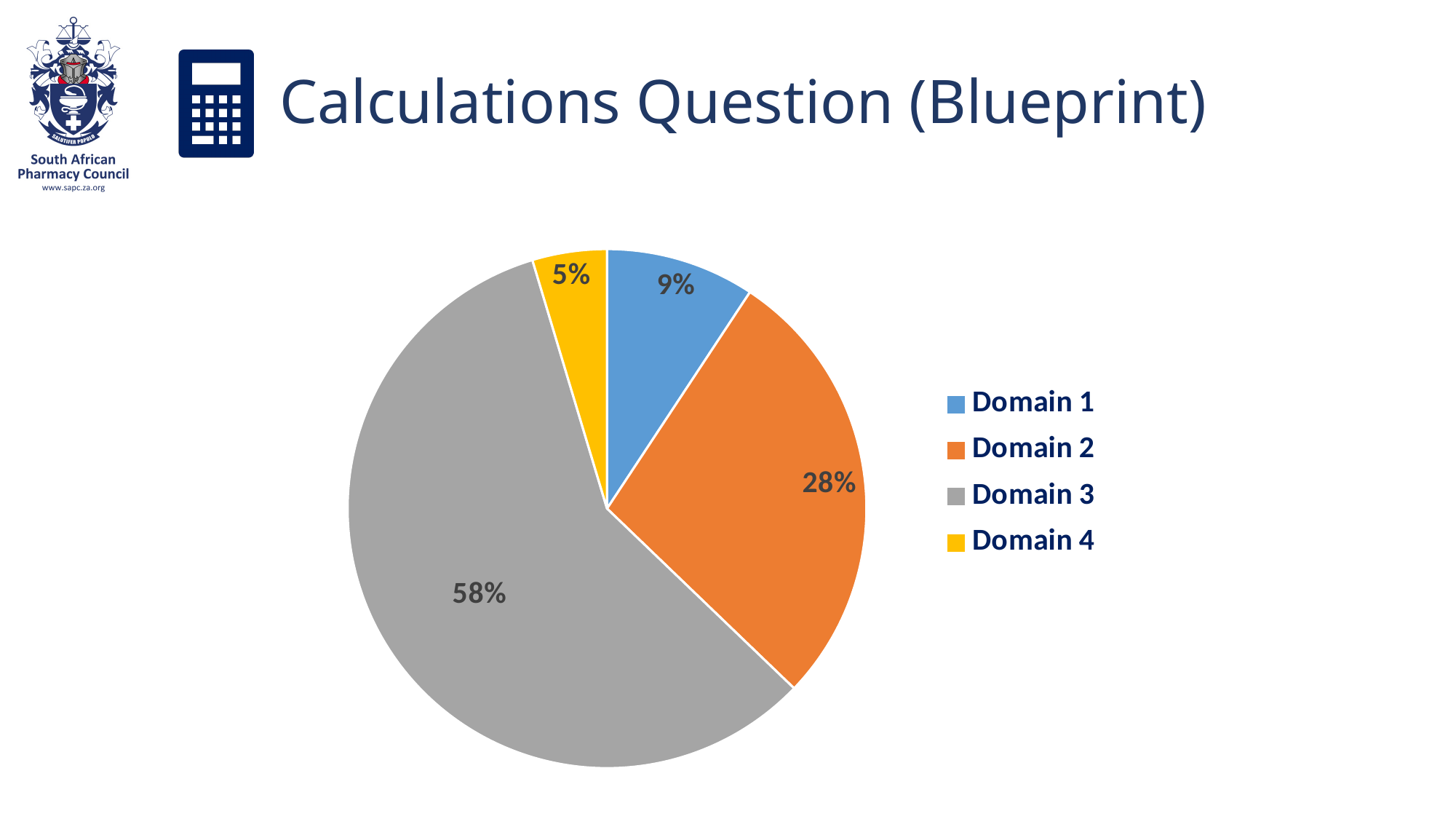
Which domain has the smallest share of the pie chart? Domain 4 What percentage does Domain 3 account for in the pie chart? 58% Which has a larger share, Domain 1 or Domain 2? Domain 2 What percentage does Domain 2 account for in the pie chart? 28% What percentage does Domain 4 account for in the pie chart? 5% What colour represents Domain 4 in the pie chart? Yellow How many entries does the legend list? 4 What type of chart is shown on the slide? Pie chart How many slices does the pie chart have? 4 What is the difference in percentage points between Domain 3 and Domain 2? 30 Which domain has the largest share of the pie chart? Domain 3 What percentage does Domain 1 account for in the pie chart? 9%